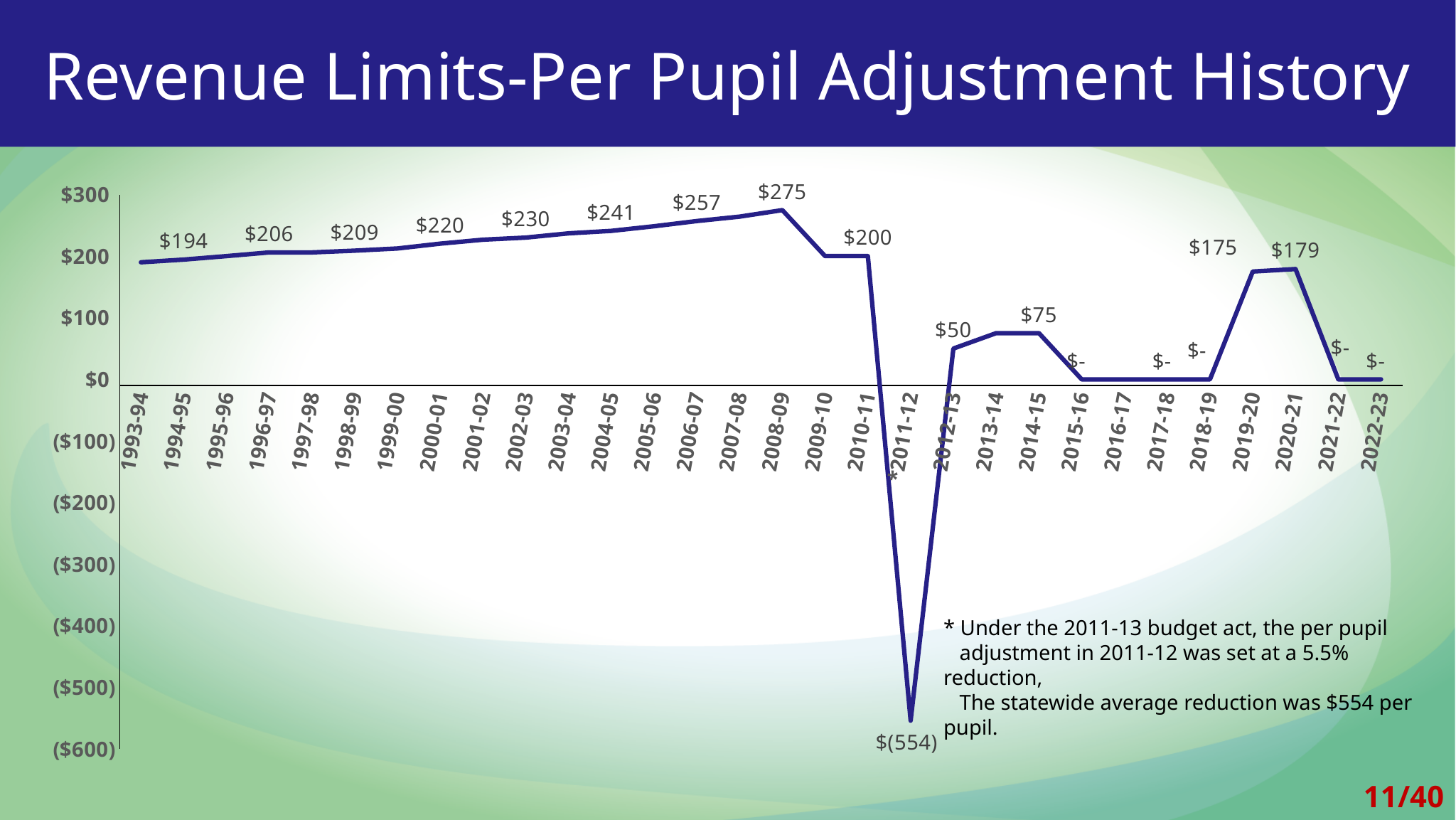
What is the per pupil adjustment value shown for 2022-23? $- Which year has the lowest per pupil adjustment? 2011-12 What is the difference between the 2008-09 value and the 2020-21 value? $96 What kind of chart is shown on the slide? line chart Which is larger, the value for 2012-13 or the value for 2014-15? 2014-15 Is the value for 2019-20 greater or less than $100? greater What is the per pupil adjustment value shown for 2020-21? $179 Do the values rise or fall from 1993-94 to 2008-09? rise Which year has the highest per pupil adjustment? 2008-09 What is the per pupil adjustment value shown for 2011-12? $(554) How many school years are shown on the x axis? 30 What is the per pupil adjustment value shown for 2008-09? $275